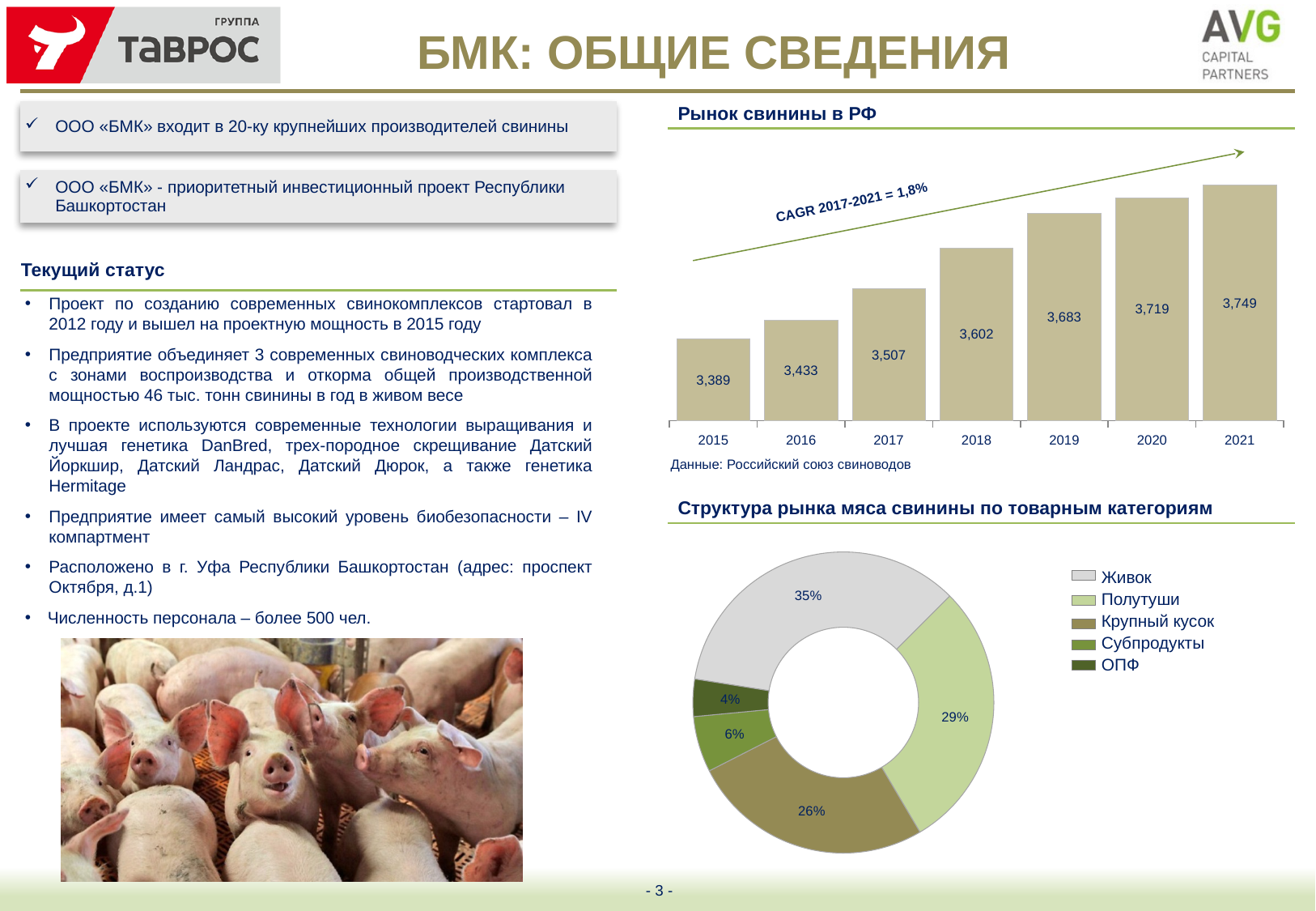
In the chart 'Рынок свинины в РФ', what CAGR for 2017-2021 is stated? 1,8% In the chart 'Структура рынка мяса свинины по товарным категориям', what share does Полутуши have? 29% In the chart 'Рынок свинины в РФ', which year has the highest value? 2021 In the chart 'Структура рынка мяса свинины по товарным категориям', how many categories does the legend list? 5 In the chart 'Рынок свинины в РФ', what is the value for 2018? 3,602 What type of chart is 'Рынок свинины в РФ'? bar chart In the chart 'Рынок свинины в РФ', what is the difference between the values for 2021 and 2020? 30 In the chart 'Рынок свинины в РФ', what is the value for 2015? 3,389 In the chart 'Рынок свинины в РФ', do the values rise or fall from 2015 to 2021? rise In the chart 'Рынок свинины в РФ', how many years are shown on the x axis? 7 In the chart 'Рынок свинины в РФ', which year has the lowest value? 2015 In the chart 'Структура рынка мяса свинины по товарным категориям', which category has the largest share? Живок